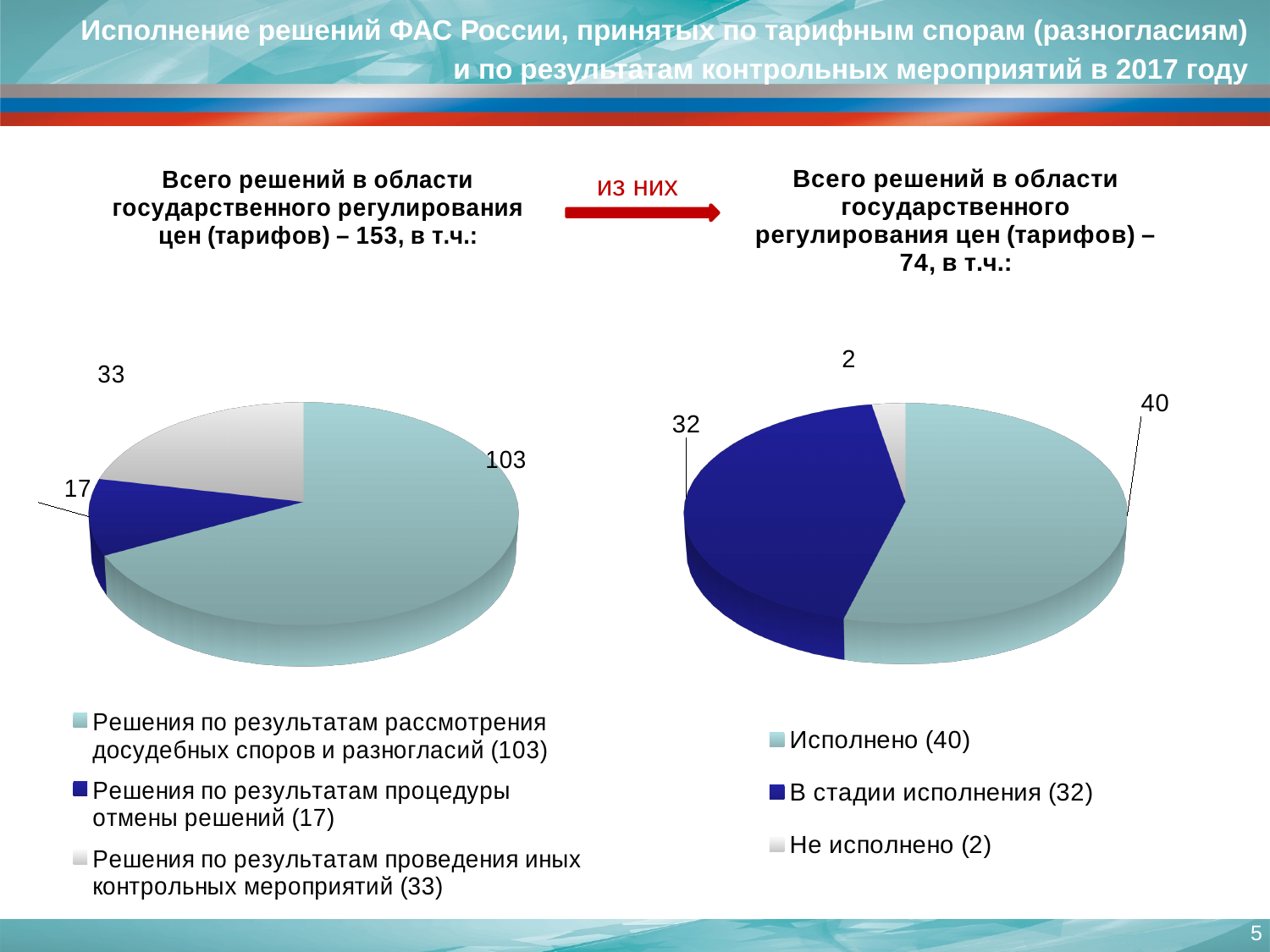
In the right pie chart, what is the total of all slices? 74 How many slices does the left pie chart have? 3 In the right pie chart, which category has the largest value? Исполнено How many entries does the legend of the right pie chart list? 3 In the left pie chart, what is the value for "Решения по результатам рассмотрения досудебных споров и разногласий"? 103 What type of chart is the left chart on the slide? pie chart In the right pie chart, what is the value for "В стадии исполнения"? 32 In the left pie chart, what is the difference between the largest slice (103) and the slice for "Решения по результатам проведения иных контрольных мероприятий" (33)? 70 In the left pie chart, what is the value for "Решения по результатам процедуры отмены решений"? 17 In the right pie chart, what is the value for "Не исполнено"? 2 In the left pie chart, which category has the smallest value? Решения по результатам процедуры отмены решений In the right pie chart, which is larger: "Исполнено" or "В стадии исполнения"? Исполнено